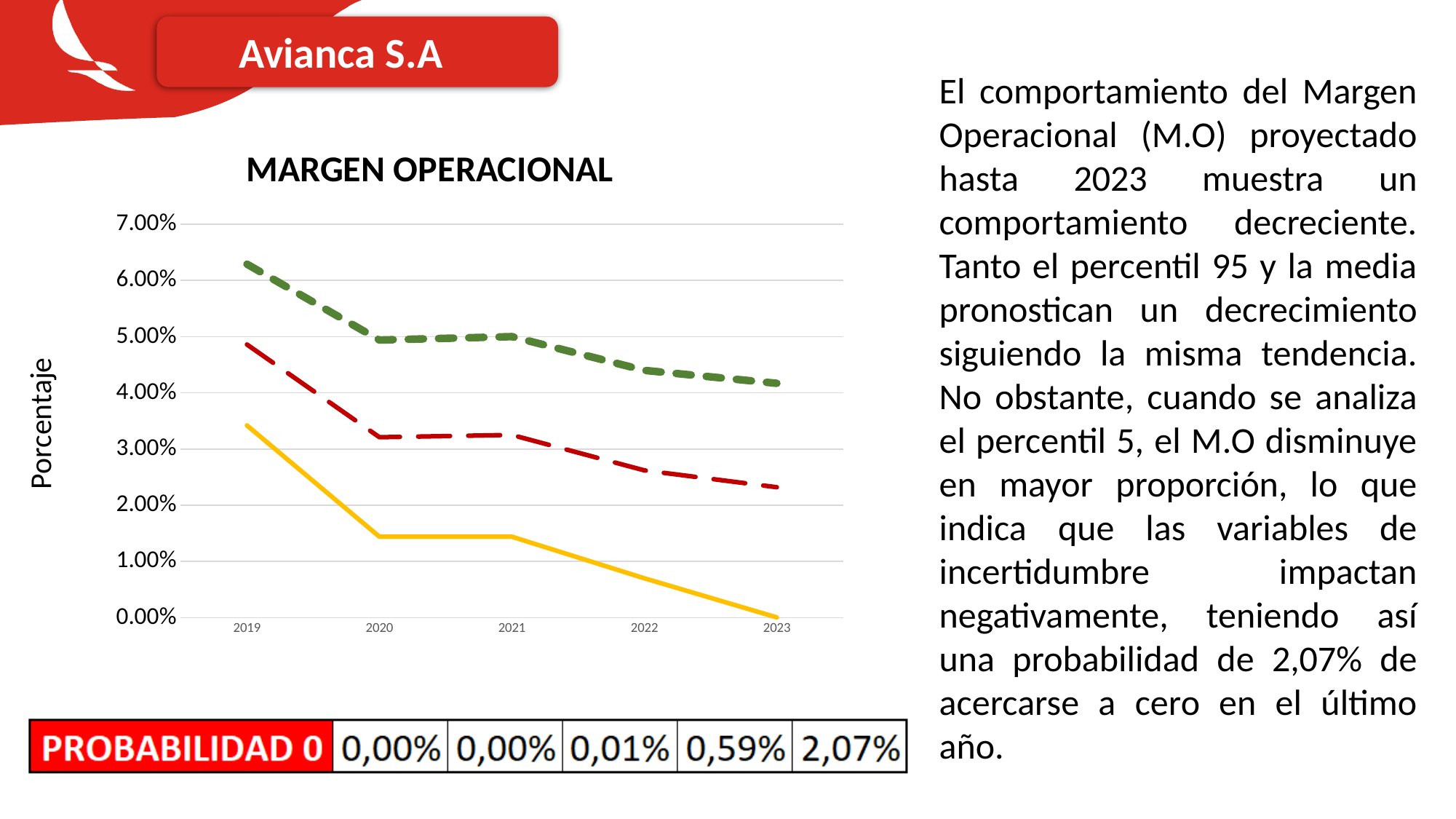
What is the label on the vertical axis of the chart? Porcentaje What is the title of the chart? MARGEN OPERACIONAL Does the yellow solid line rise or fall from 2019 to 2023? fall Which line has the highest value in 2019: the green dashed, red dashed or yellow solid line? green dashed Is the value of the green dashed line in 2019 greater or less than 6.00%? greater How many lines are plotted in the chart? 3 Which line has the lowest value in 2023: the green dashed, red dashed or yellow solid line? yellow solid What type of chart is shown under the title MARGEN OPERACIONAL? line chart Is the value of the yellow solid line in 2023 greater or less than 1.00%? less How many years are shown along the x axis of the chart? 5 Is the value of the red dashed line in 2023 greater or less than 3.00%? less Does the green dashed line rise or fall overall from 2019 to 2023? fall